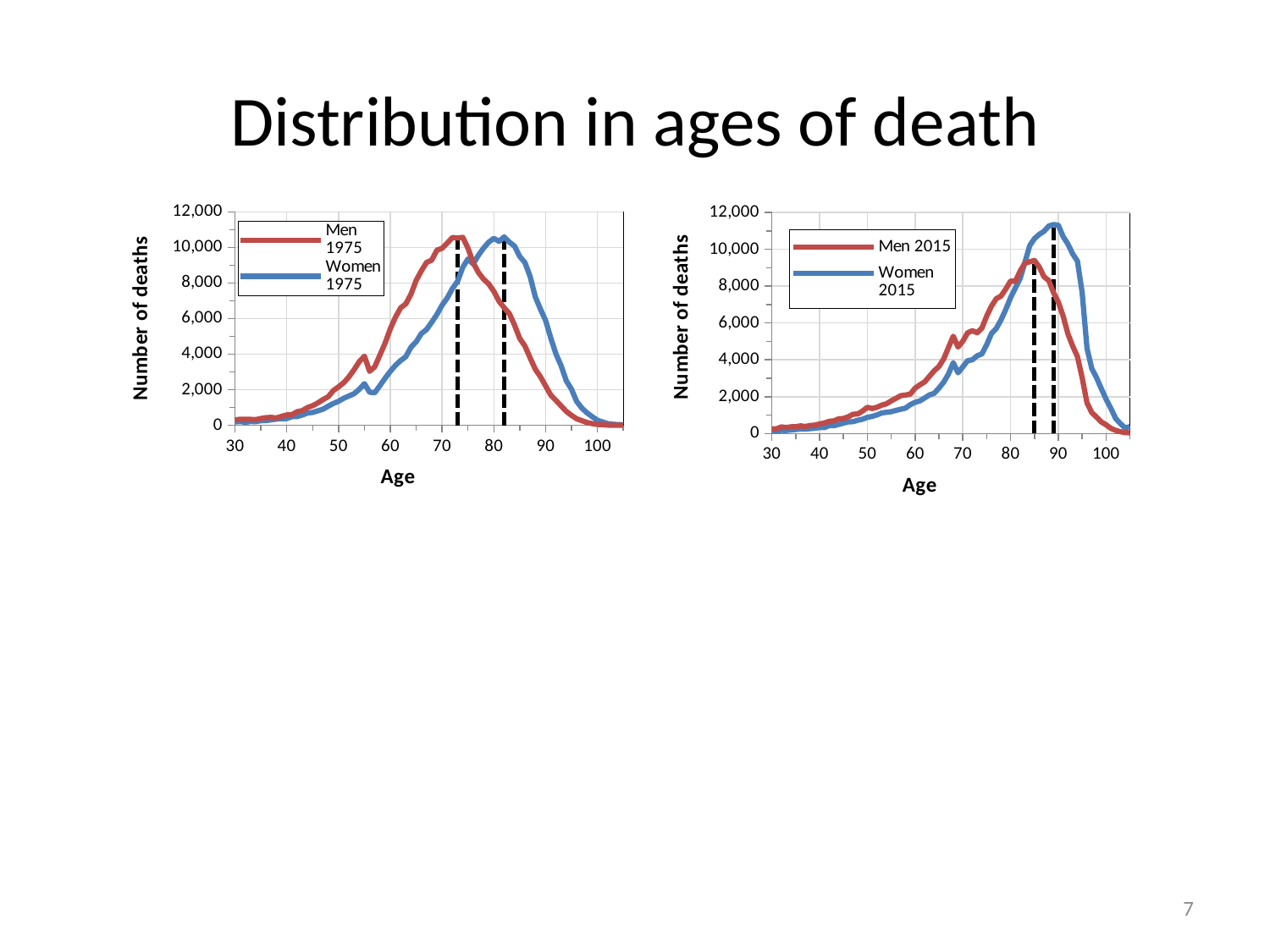
In the right chart, is the value for Men 2015 at age 70 greater or less than 4,000? greater In the left chart, what are the two series named in the legend? Men 1975 and Women 1975 How many series does the legend of the right chart (2015) list? 2 In the left chart, is the value for Women 1975 at age 60 greater or less than 4,000? less In the left chart, does the Men 1975 line rise or fall between age 30 and age 70? rise In the right chart, is the peak value of the Women 2015 line greater or less than 10,000? greater In the right chart, which series reaches the higher peak, Men 2015 or Women 2015? Women 2015 What kind of chart is the left chart (1975)? line chart What is the label on the vertical axis of the left chart? Number of deaths In the right chart, does the Women 2015 line rise or fall between age 90 and age 100? fall